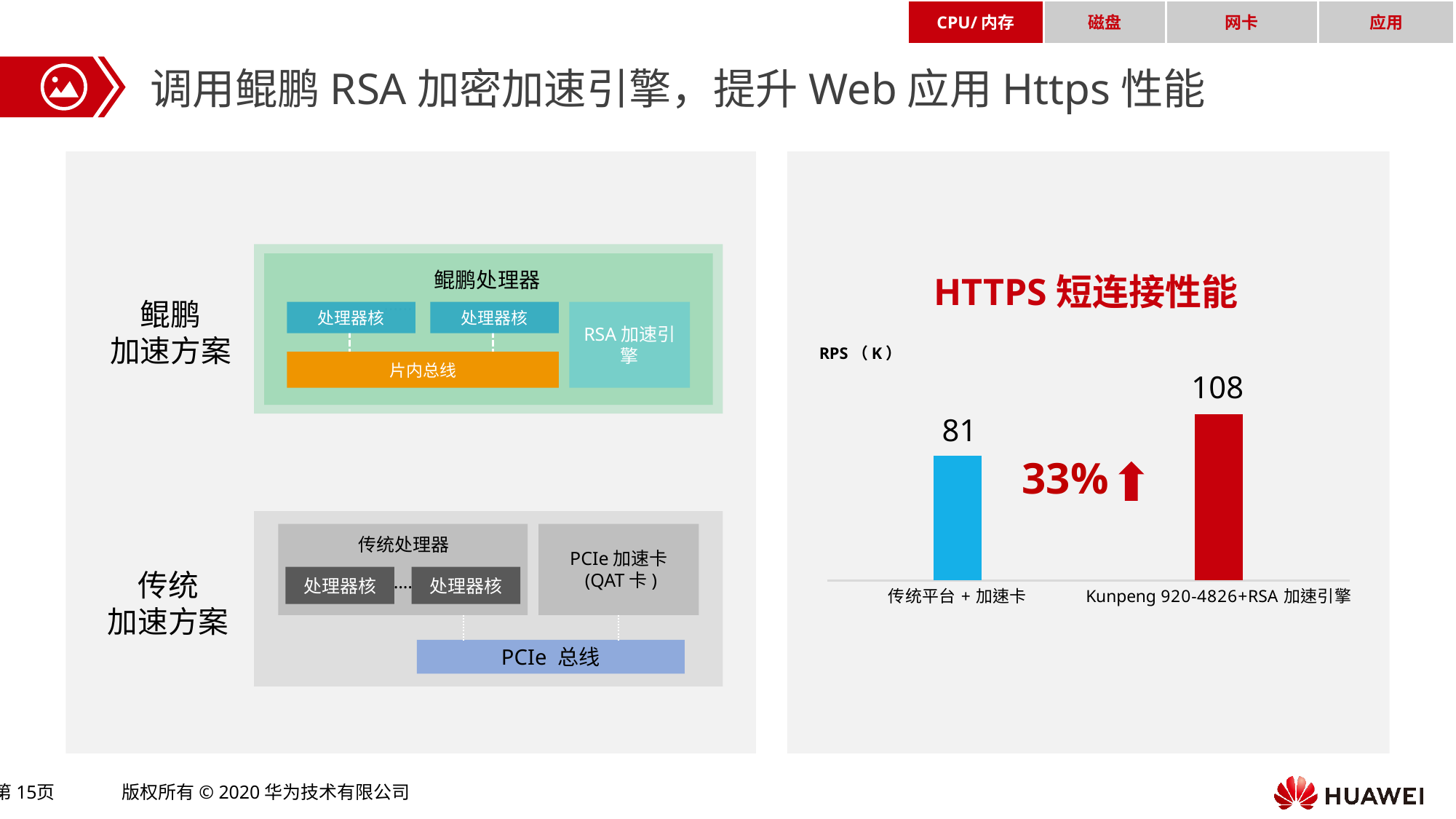
Which category has the lowest RPS (K) value? 传统平台 + 加速卡 What is the difference in RPS (K) between Kunpeng 920-4826+RSA 加速引擎 and 传统平台 + 加速卡? 27 What is the RPS (K) value for Kunpeng 920-4826+RSA 加速引擎? 108 What is the RPS (K) value for 传统平台 + 加速卡? 81 What unit is shown for the values in the HTTPS 短连接性能 chart? RPS（K） What percentage improvement is annotated between the two bars in the chart? 33% Which category has the highest RPS (K) value? Kunpeng 920-4826+RSA 加速引擎 What is the title of the chart on the right side of the slide? HTTPS 短连接性能 What kind of chart is the HTTPS 短连接性能 chart? bar chart Which is larger, the RPS (K) for 传统平台 + 加速卡 or for Kunpeng 920-4826+RSA 加速引擎? Kunpeng 920-4826+RSA 加速引擎 How many bars are shown in the HTTPS 短连接性能 chart? 2